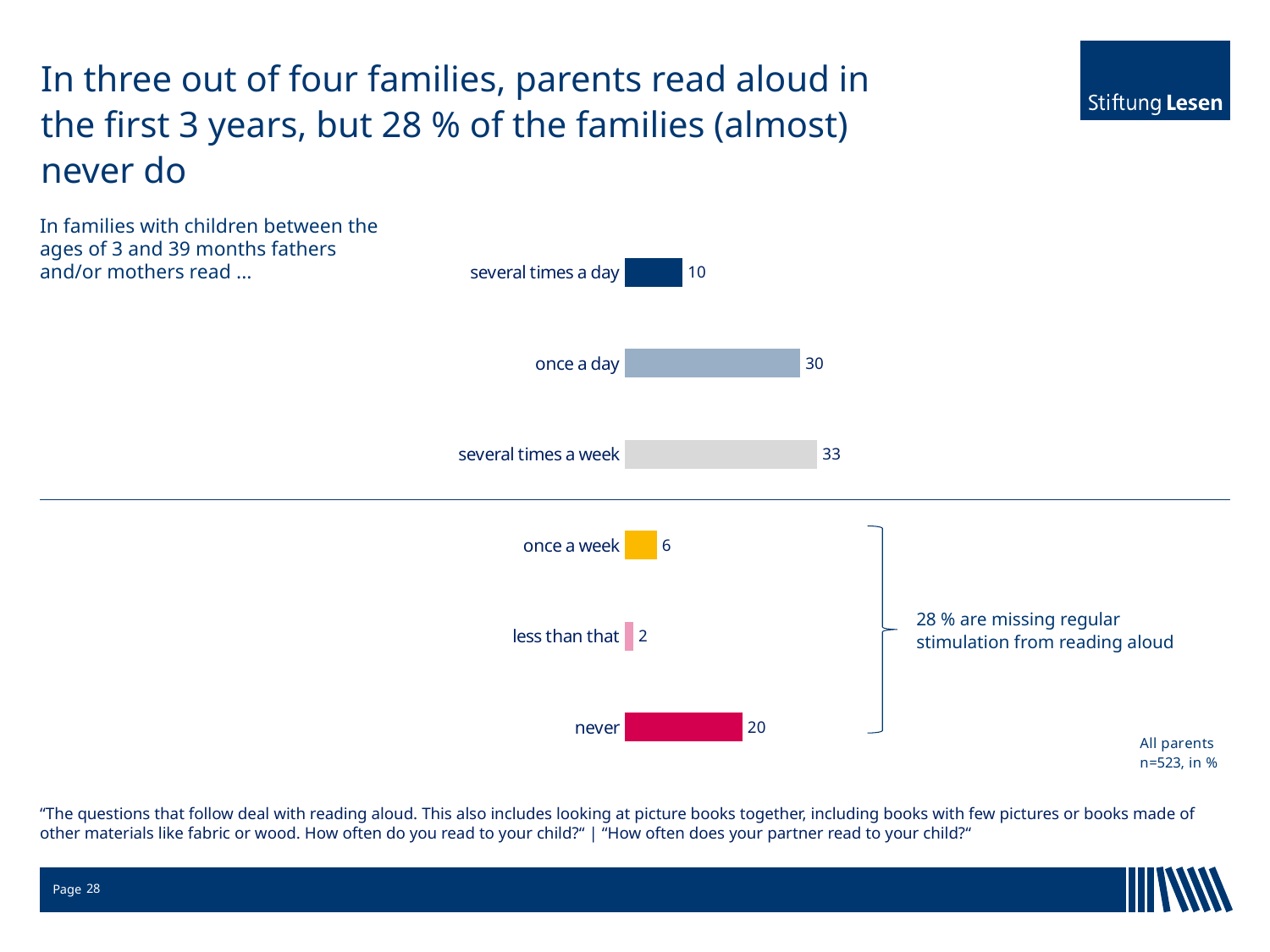
What is the value for "once a day"? 30 What is the value for "never"? 20 Which category has the highest value? several times a week What is the difference between the values for "never" and "once a week"? 14 How many categories are shown in the chart? 6 What is the difference between the values for "several times a week" and "once a day"? 3 What is the sample size stated on the slide? n=523 What is the value for "less than that"? 2 Which category has the lowest value? less than that What kind of chart is shown on the slide? bar chart Which is larger, the value for "never" or the value for "several times a day"? never What is the value for "several times a day"? 10